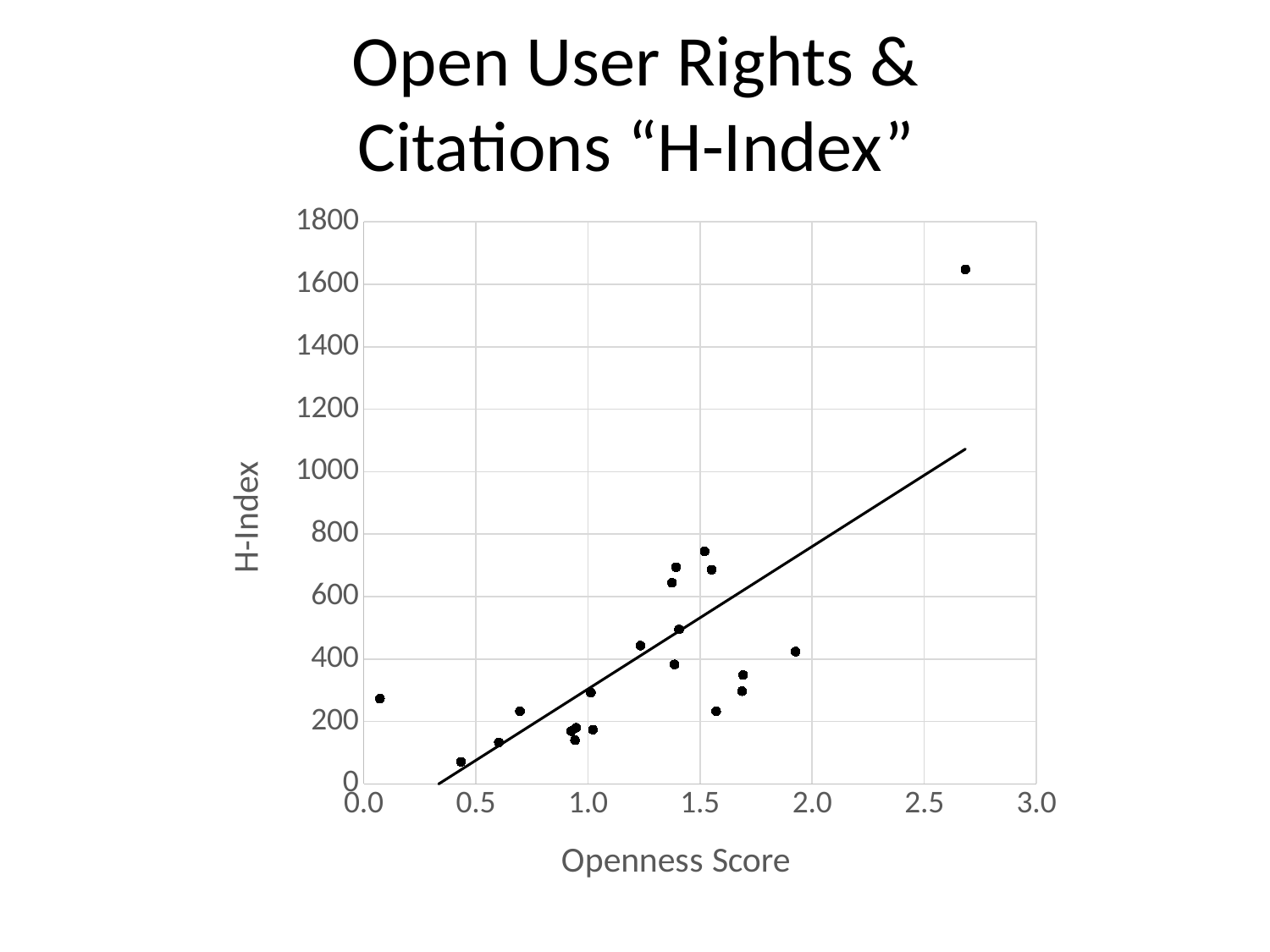
Is the H-Index of the lowest point on the chart greater or less than 100? less What is the title of the chart? Open User Rights & Citations “H-Index” What is the highest value shown on the x axis? 3.0 Is the H-Index of the highest point on the chart greater or less than 1600? greater How many points on the chart have an H-Index above 1000? 1 As Openness Score increases along the x axis, does the H-Index generally rise or fall? Rise What kind of chart is shown on the slide? Scatter plot Does the fitted trend line on the chart slope upward or downward from left to right? Upward How many points on the chart have an Openness Score above 2.0? 1 What is the label on the x axis of the chart? Openness Score